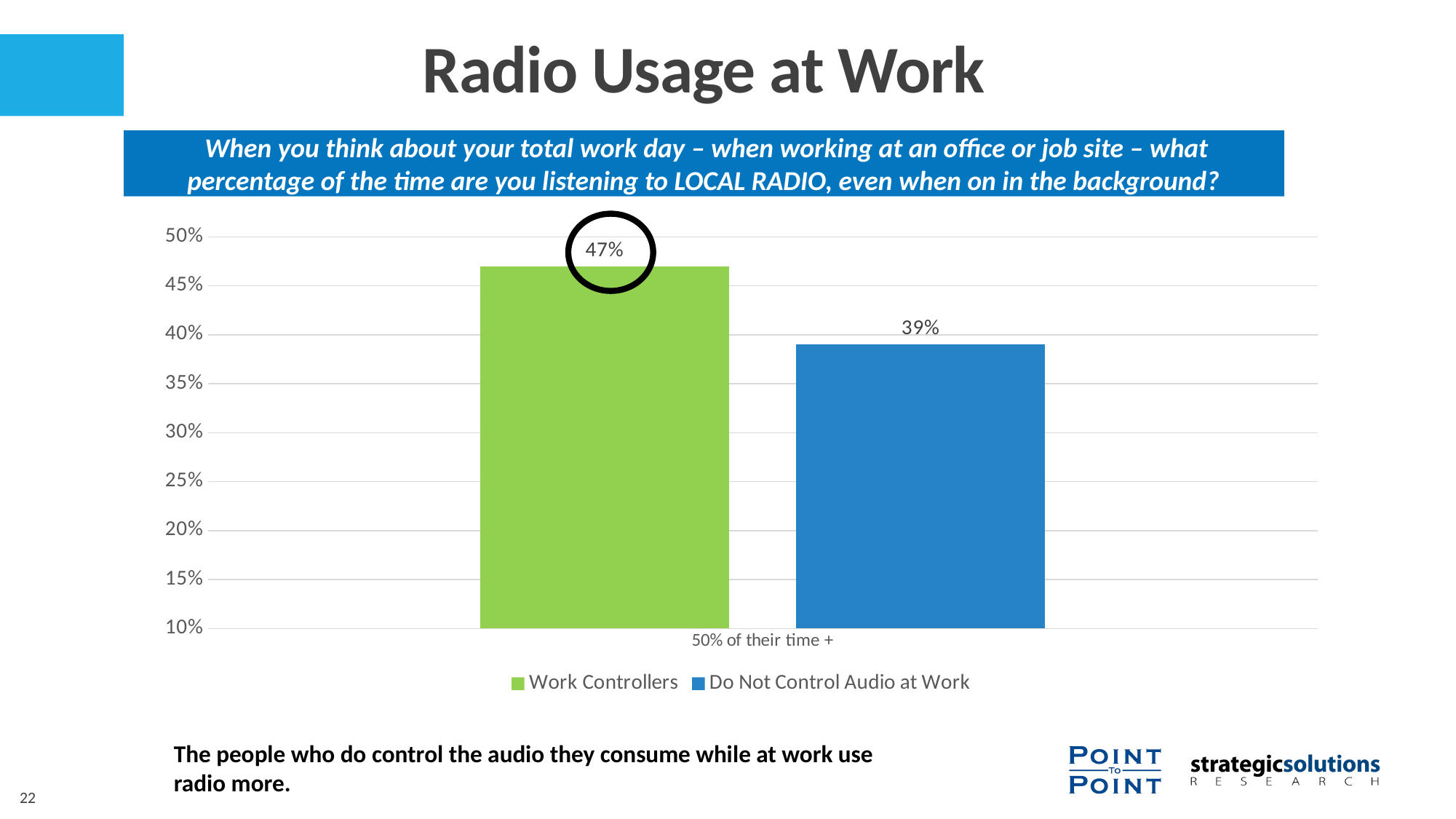
How many series does the legend list? 2 What kind of chart is shown on the slide? bar chart Is the value for Do Not Control Audio at Work greater or less than 40%? less What is the value for Do Not Control Audio at Work? 39% Which series has the lower value? Do Not Control Audio at Work What is the value for Work Controllers? 47% Is the value for Work Controllers larger or smaller than the value for Do Not Control Audio at Work? larger What is the category label shown on the x axis? 50% of their time + What colour is the bar for Work Controllers? green Is the value for Work Controllers greater or less than 45%? greater Which series has the higher value? Work Controllers What is the difference between the Work Controllers value and the Do Not Control Audio at Work value? 8%